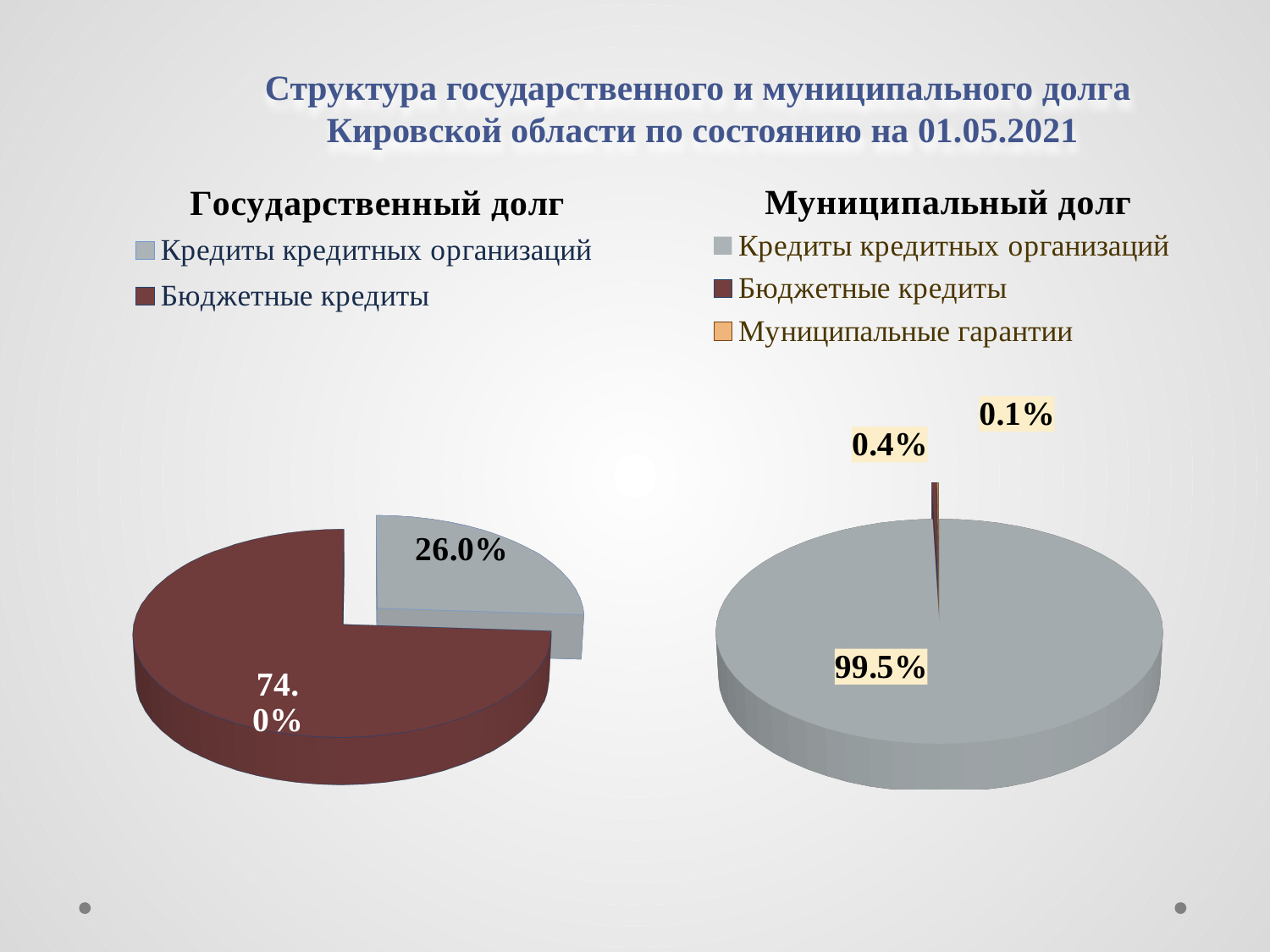
In the "Государственный долг" chart, what is the difference between the shares of Бюджетные кредиты and Кредиты кредитных организаций? 48.0% In the "Государственный долг" chart, what share is shown for Бюджетные кредиты? 74.0% In the "Государственный долг" chart, which category has the largest slice? Бюджетные кредиты Which chart shows a larger share for Кредиты кредитных организаций, "Государственный долг" or "Муниципальный долг"? Муниципальный долг How many categories does the legend of the "Государственный долг" chart list? 2 What kind of chart is the "Государственный долг" chart? pie chart In the "Муниципальный долг" chart, what share is shown for Кредиты кредитных организаций? 99.5% In the "Муниципальный долг" chart, which category has the largest slice? Кредиты кредитных организаций How many categories does the legend of the "Муниципальный долг" chart list? 3 What is the title of the slide above the two charts? Структура государственного и муниципального долга Кировской области по состоянию на 01.05.2021 In the "Муниципальный долг" chart, what is the smallest percentage value shown? 0.1% In the "Государственный долг" chart, what share is shown for Кредиты кредитных организаций? 26.0%